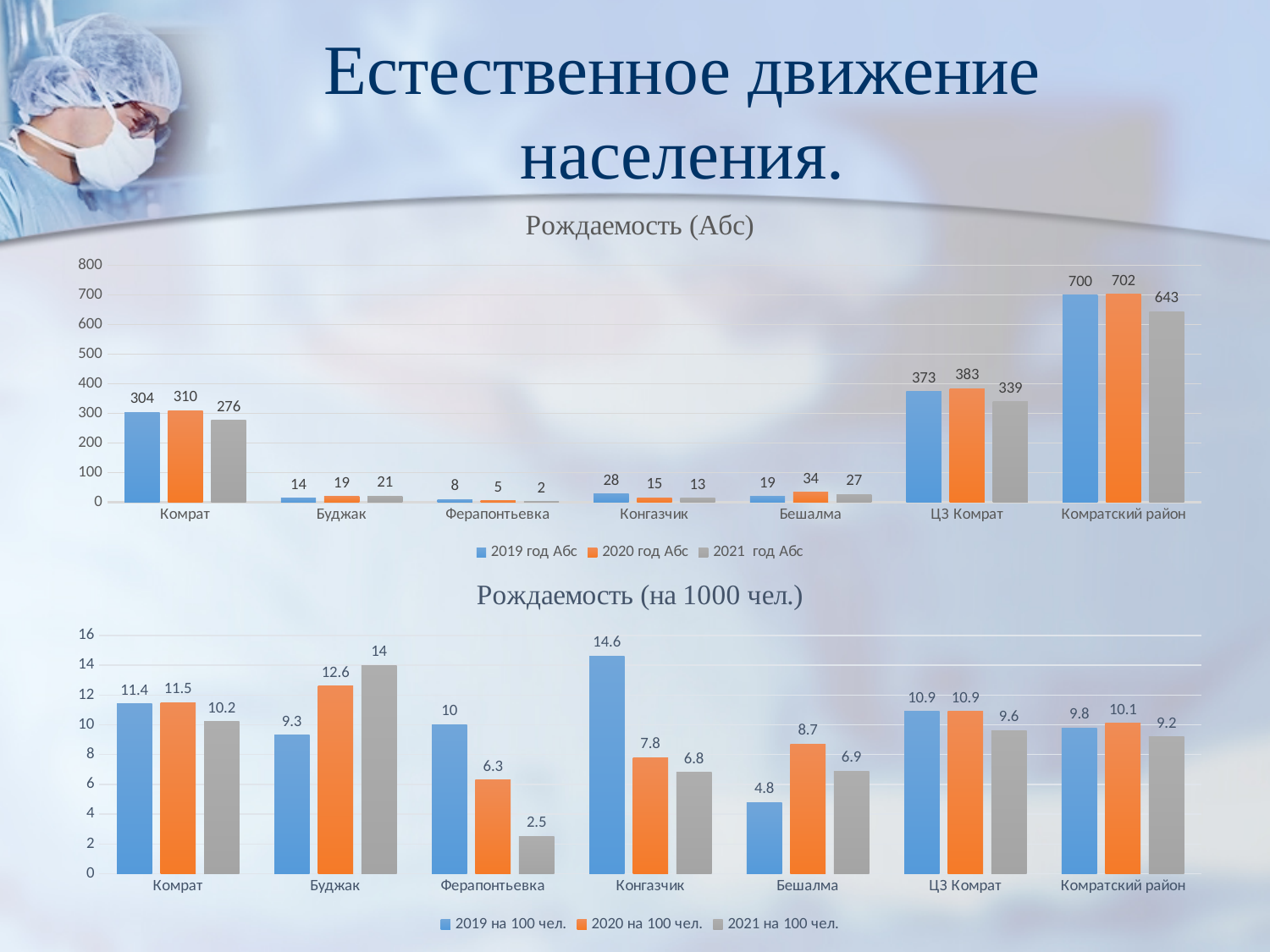
In the chart titled 'Рождаемость (Абс)', what is the value for Комратский район in the 2021 год Абс series? 643 In the chart titled 'Рождаемость (Абс)', how many categories are shown on the x axis? 7 In the chart titled 'Рождаемость (Абс)', what is the difference between the 2020 год Абс and 2021 год Абс values for ЦЗ Комрат? 44 In the chart titled 'Рождаемость (на 1000 чел.)', which category has the highest value in the 2021 на 100 чел. series? Буджак What kind of chart is the chart titled 'Рождаемость (на 1000 чел.)'? bar chart In the chart titled 'Рождаемость (Абс)', what is the value for Комрат in the 2019 год Абс series? 304 In the chart titled 'Рождаемость (Абс)', which category has the lowest value in the 2021 год Абс series? Ферапонтьевка In the chart titled 'Рождаемость (Абс)', how many series does the legend list? 3 In the chart titled 'Рождаемость (на 1000 чел.)', which is larger for Бешалма: the 2019 на 100 чел. value or the 2020 на 100 чел. value? 2020 на 100 чел. In the chart titled 'Рождаемость (на 1000 чел.)', what is the value for Конгазчик in the 2019 на 100 чел. series? 14.6 In the chart titled 'Рождаемость (на 1000 чел.)', do the values for Ферапонтьевка rise or fall from 2019 to 2021? fall In the chart titled 'Рождаемость (на 1000 чел.)', what is the difference between the 2019 на 100 чел. and 2021 на 100 чел. values for Ферапонтьевка? 7.5